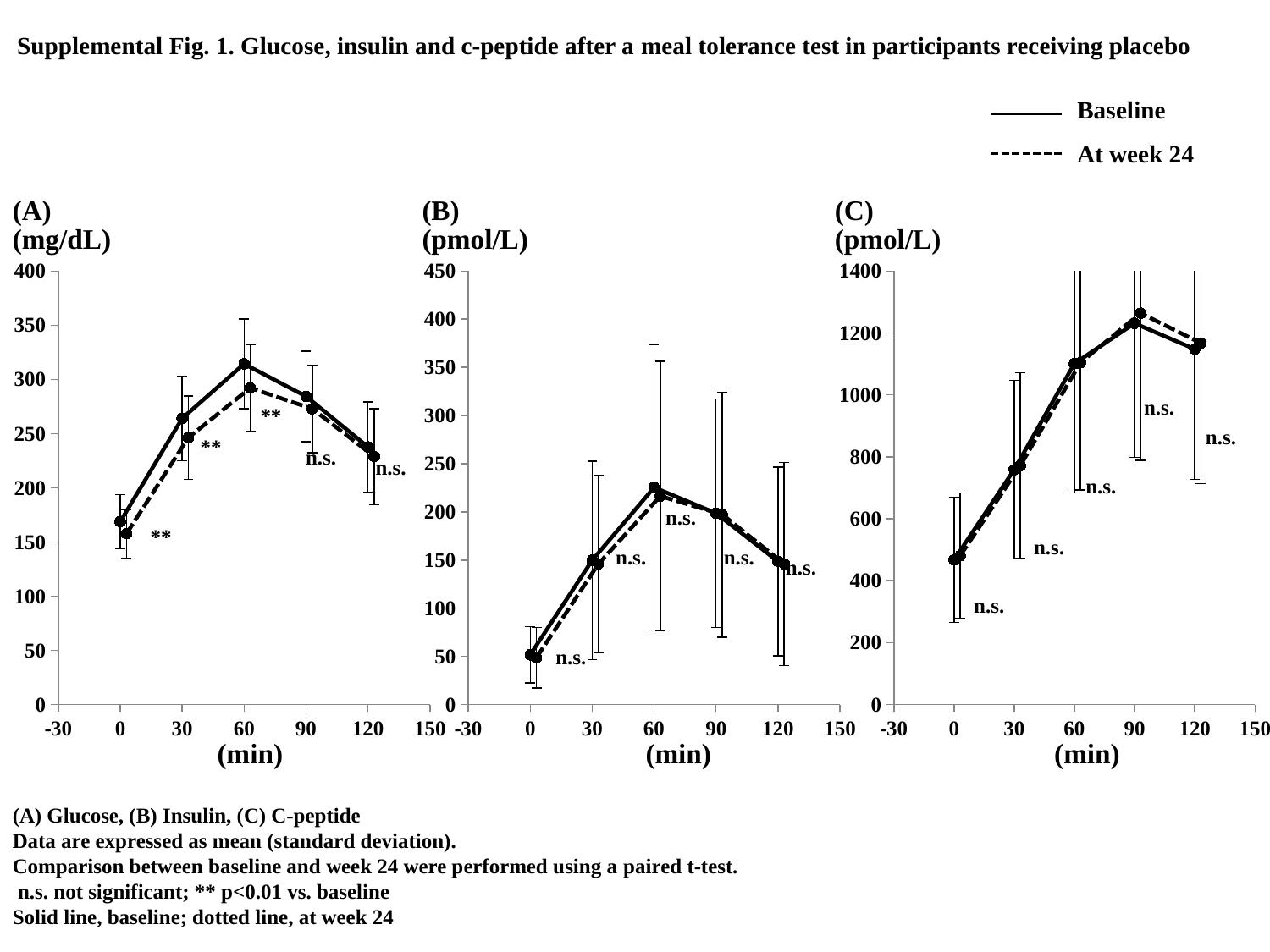
In chart (C), at which time point does the Baseline C-peptide reach its highest value? 90 min In chart (A), how many time points are plotted for the Baseline series? 5 In chart (C), is the Baseline value at 30 min greater or less than 600? greater How many series does the legend list? 2 In chart (C), do the Baseline values rise or fall from 0 min to 90 min? rise In chart (A), at which time point does the Baseline glucose reach its highest value? 60 min In chart (B), is the Baseline value at 0 min greater or less than 100? less What kind of chart is chart (A)? line chart What are the units shown on the y axis of chart (A)? mg/dL In chart (B), at which time point is the Baseline insulin lowest? 0 min In chart (A), is the Baseline value at 60 min greater or less than 300? greater In chart (A), at 0 min, which series has the higher value, Baseline or At week 24? Baseline